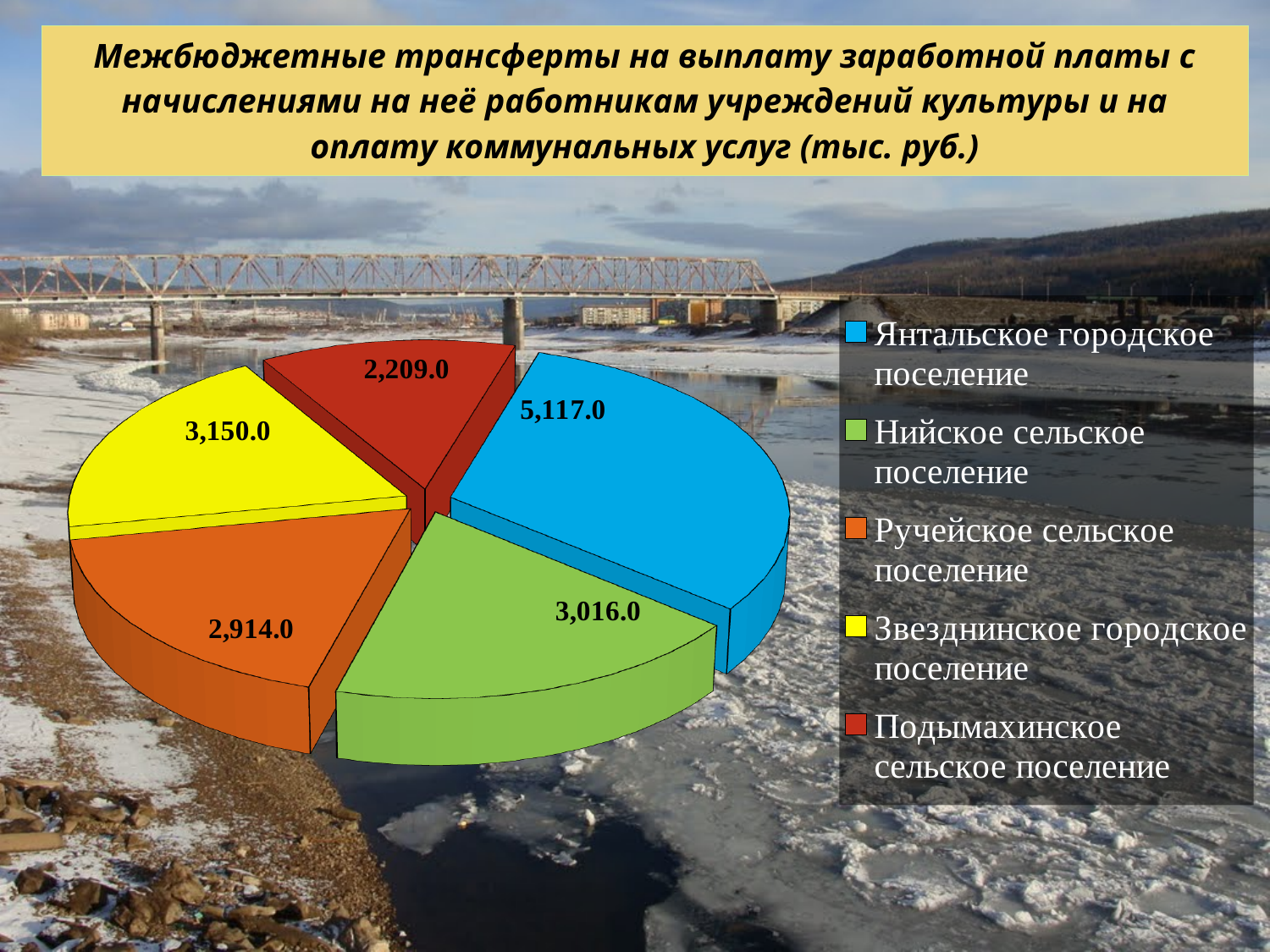
Which settlement has the largest slice of the pie? Янтальское городское поселение What is the total of all the values shown in the pie chart? 16,406.0 How many slices does the pie chart have? 5 What is the value for Подымахинское сельское поселение? 2,209.0 What is the value for Звезднинское городское поселение? 3,150.0 Which is larger, the value for Нийское сельское поселение or the value for Ручейское сельское поселение? Нийское сельское поселение What is the value for Янтальское городское поселение? 5,117.0 What is the difference between the values for Звезднинское городское поселение and Нийское сельское поселение? 134.0 Which colour represents Ручейское сельское поселение in the legend? orange Which settlement has the smallest slice of the pie? Подымахинское сельское поселение What is the difference between the values for Янтальское городское поселение and Подымахинское сельское поселение? 2,908.0 What type of chart is shown on the slide? pie chart